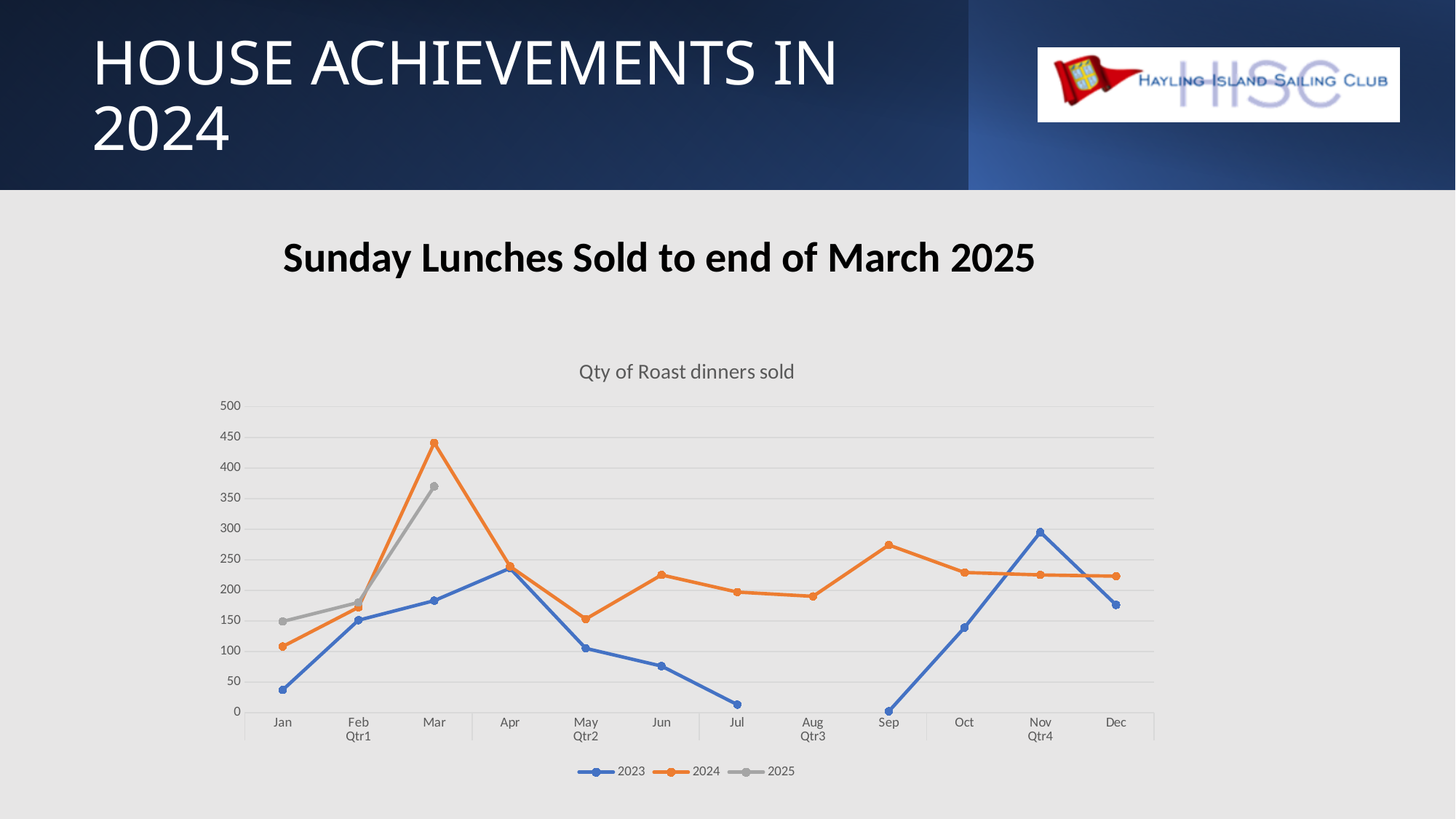
Is the value for 2025 in Mar greater or less than 350? greater What kind of chart is shown on the slide? line chart What is the title printed above the chart's plot area? Qty of Roast dinners sold Is the value for 2024 in Mar greater or less than 400? greater Is the value for 2024 in Jan greater or less than 150? less In which month does the 2023 series reach its highest value? Nov Does the 2025 series rise or fall from Jan to Mar? rise How many months are shown along the x axis? 12 In which month does the 2024 series reach its highest value? Mar How many series does the legend list? 3 Which series has the larger value in Nov, 2023 or 2024? 2023